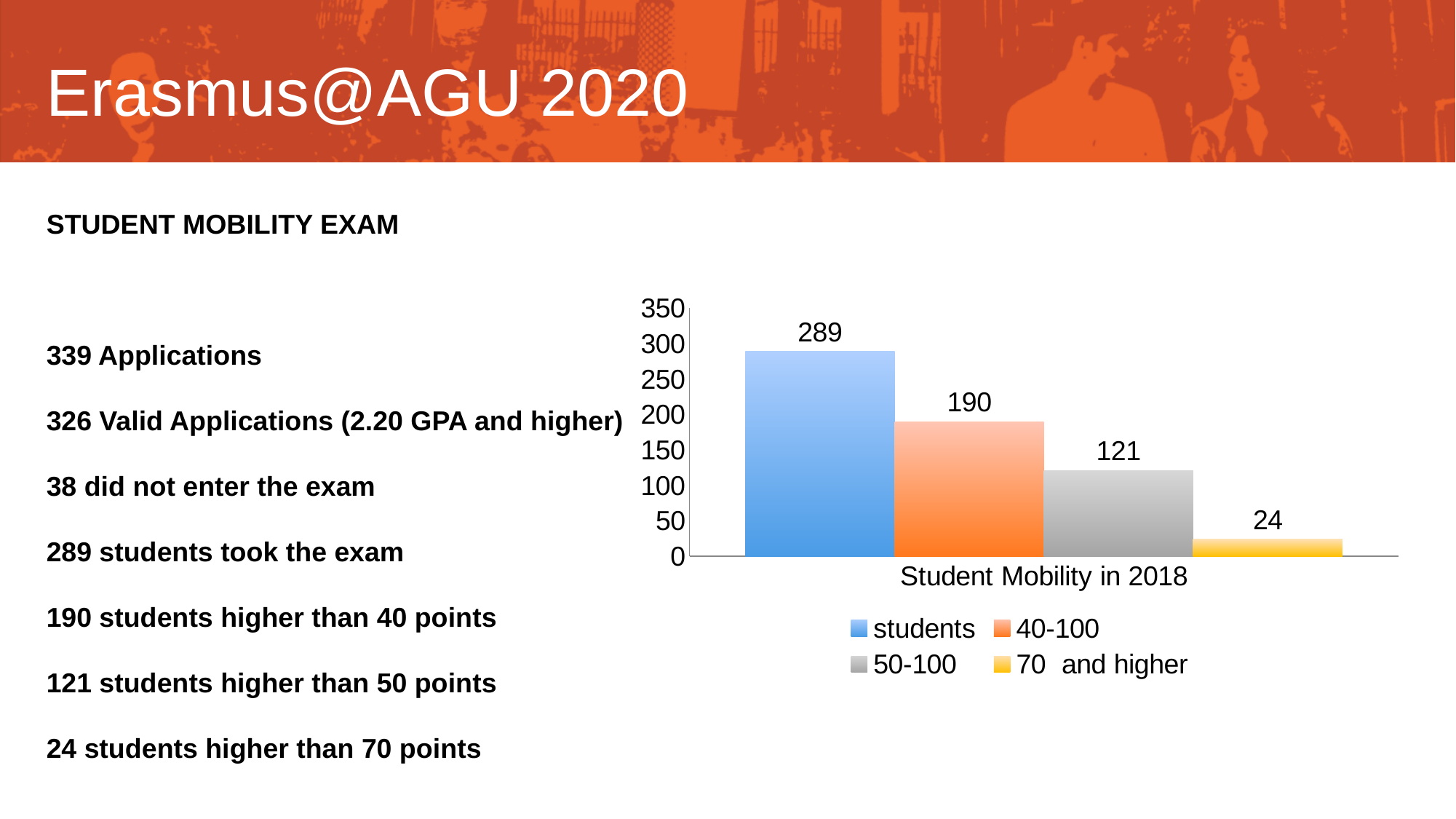
What is the category label shown on the x axis of the chart? Student Mobility in 2018 What is the value for the "students" series in the chart? 289 What is the difference between the "50-100" value and the "70 and higher" value? 97 Which is larger, the value for "40-100" or the value for "50-100"? 40-100 Which series has the highest value in the chart? students What is the value for the "70 and higher" series in the chart? 24 What is the value for the "40-100" series in the chart? 190 Which series has the lowest value in the chart? 70 and higher What is the value for the "50-100" series in the chart? 121 What is the difference between the "students" value and the "40-100" value? 99 What kind of chart is shown on the slide? Bar chart How many series does the legend list? 4